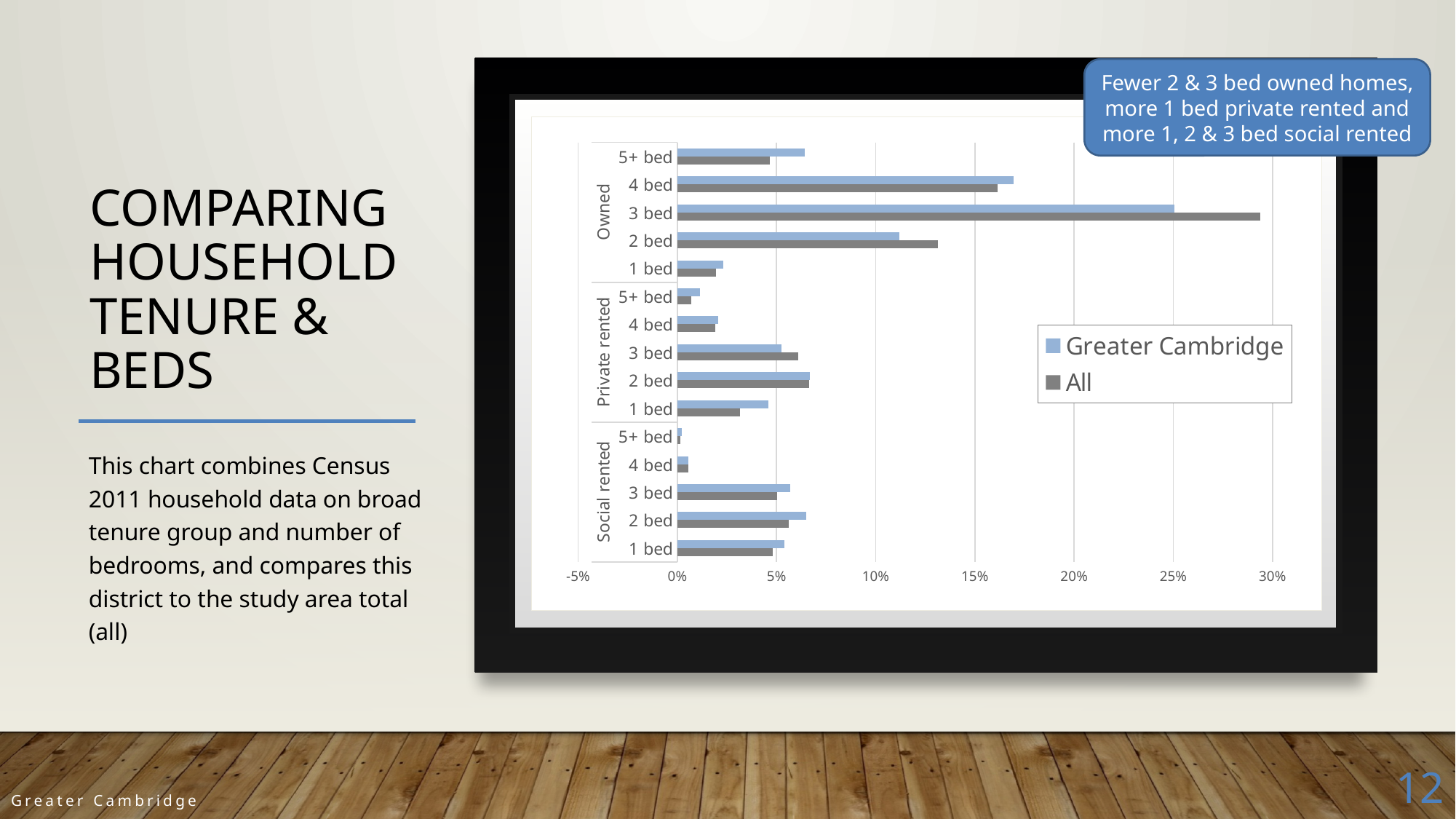
Is the Greater Cambridge value for Owned 2 bed greater or less than 10%? greater Is the Greater Cambridge value for Owned 4 bed greater or less than 15%? greater What kind of chart is shown on the slide? bar chart For Owned 3 bed, which series has the larger value, Greater Cambridge or All? All Is the All value for Owned 3 bed greater or less than 25%? greater Which category has the highest value for the All series? Owned 3 bed Which category has the lowest value for the Greater Cambridge series? Social rented 5+ bed Which category has the highest value for the Greater Cambridge series? Owned 3 bed Which two series are listed in the chart legend? Greater Cambridge and All How many tenure-and-bedroom categories are plotted on the chart? 15 How many series does the chart legend list? 2 For Owned 5+ bed, which series has the larger value, Greater Cambridge or All? Greater Cambridge